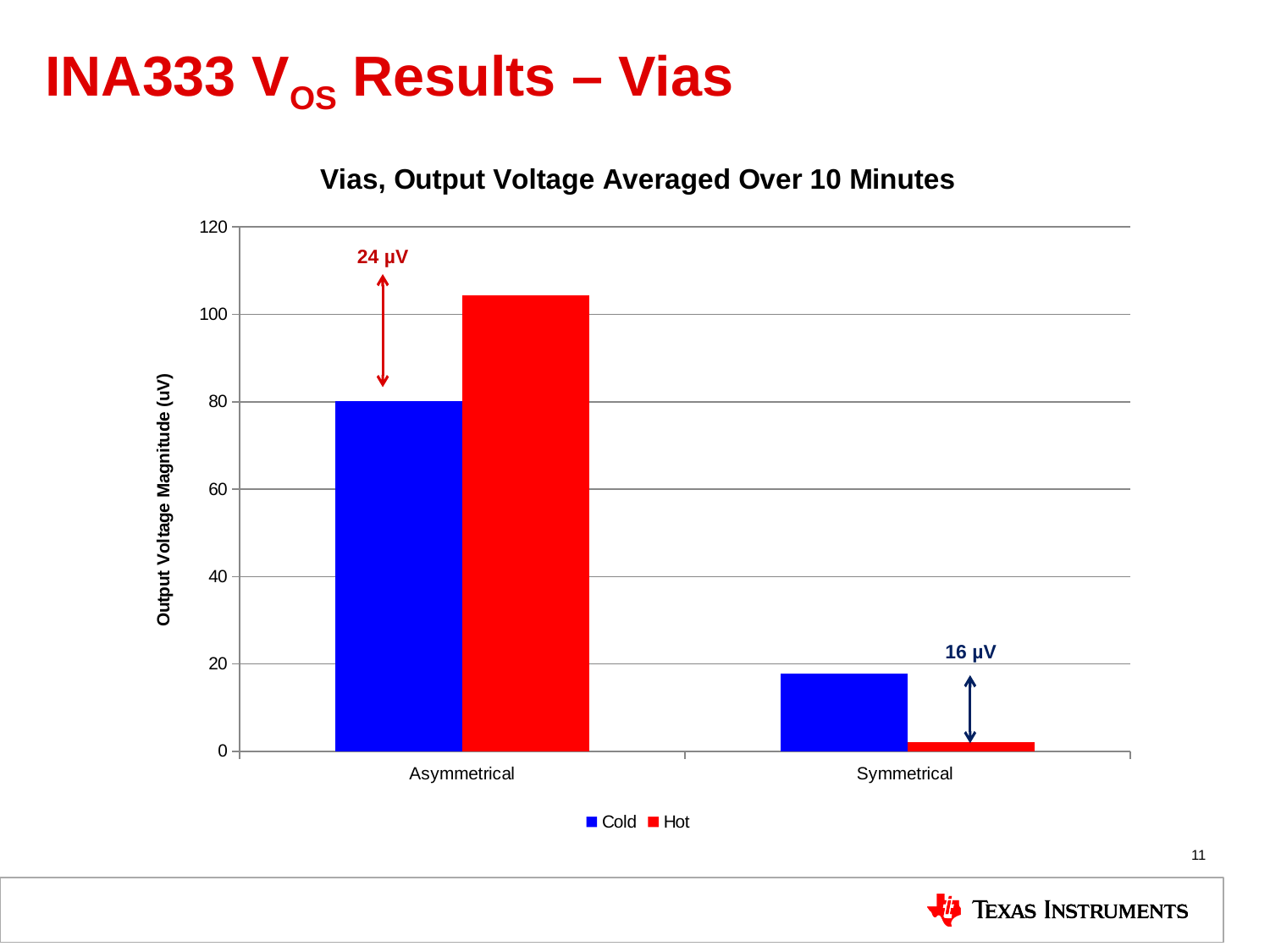
Is the Cold value for Symmetrical greater or less than 20? less For Symmetrical, which is larger, the Cold value or the Hot value? Cold What type of chart is shown on the slide? bar chart How many categories are shown on the x axis? 2 What is the labelled difference between the Hot and Cold bars for Asymmetrical? 24 µV What is the labelled difference between the Cold and Hot bars for Symmetrical? 16 µV Is the Hot value for Asymmetrical greater or less than 100? greater Which category has the lowest Cold value? Symmetrical What is the title of the chart? Vias, Output Voltage Averaged Over 10 Minutes For Asymmetrical, which is larger, the Cold value or the Hot value? Hot Which category has the highest Hot value? Asymmetrical How many series does the legend list? 2